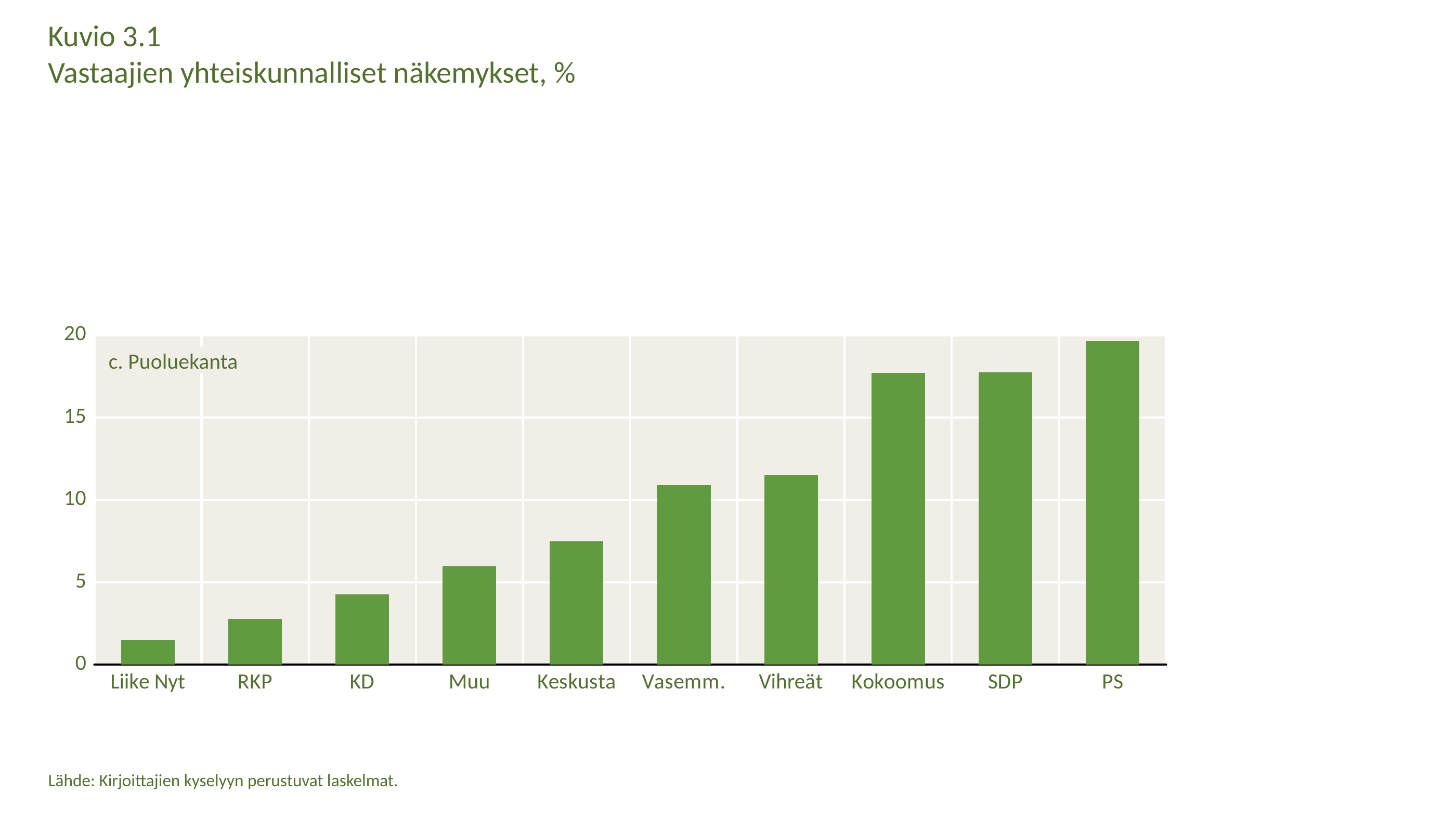
Do the bar values rise or fall from left to right along the x axis? rise What label is printed inside the top-left corner of the plot area? c. Puoluekanta Which category has the lowest bar in the chart? Liike Nyt Which category has the highest bar in the chart? PS Is the value for KD greater or less than 5? less Is the value for Keskusta greater or less than 10? less Which is larger, the value for Vihreät or the value for Keskusta? Vihreät Is the value for Kokoomus greater or less than 15? greater How many categories are shown on the x axis of the chart? 10 What kind of chart is shown on the slide? bar chart